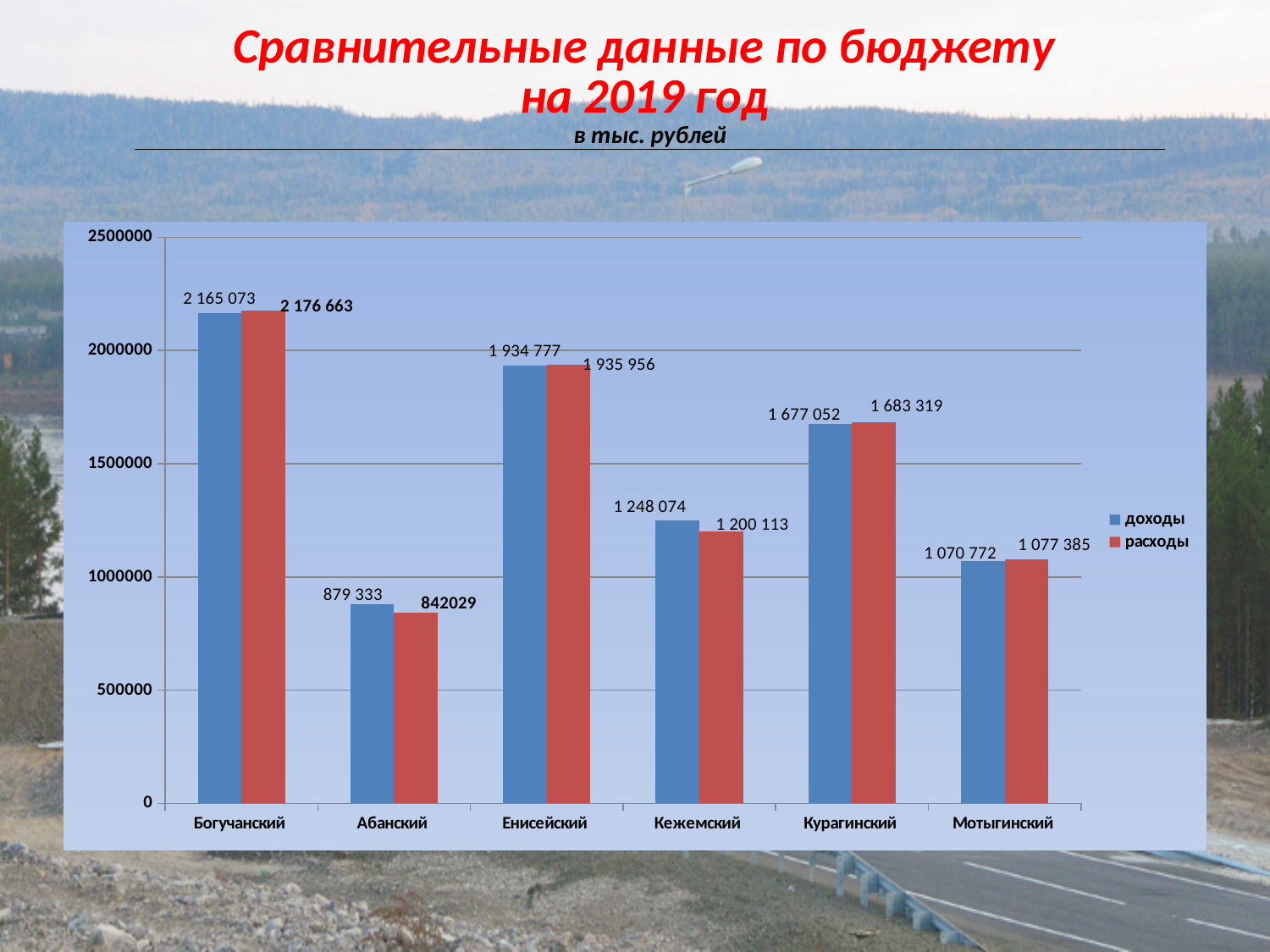
What type of chart is shown on the slide? bar chart Which district has the highest доходы? Богучанский How many districts (categories) are shown on the x axis? 6 Which district has the lowest расходы? Абанский How many series does the legend list? 2 What unit is stated under the chart title? в тыс. рублей What is the difference between доходы and расходы for Кежемский? 47 961 What is the value of расходы for Кежемский? 1 200 113 For Абанский, which is larger: доходы or расходы? доходы What is the value of доходы for Богучанский? 2 165 073 What is the value of доходы for Мотыгинский? 1 070 772 What is the value of расходы for Абанский? 842029